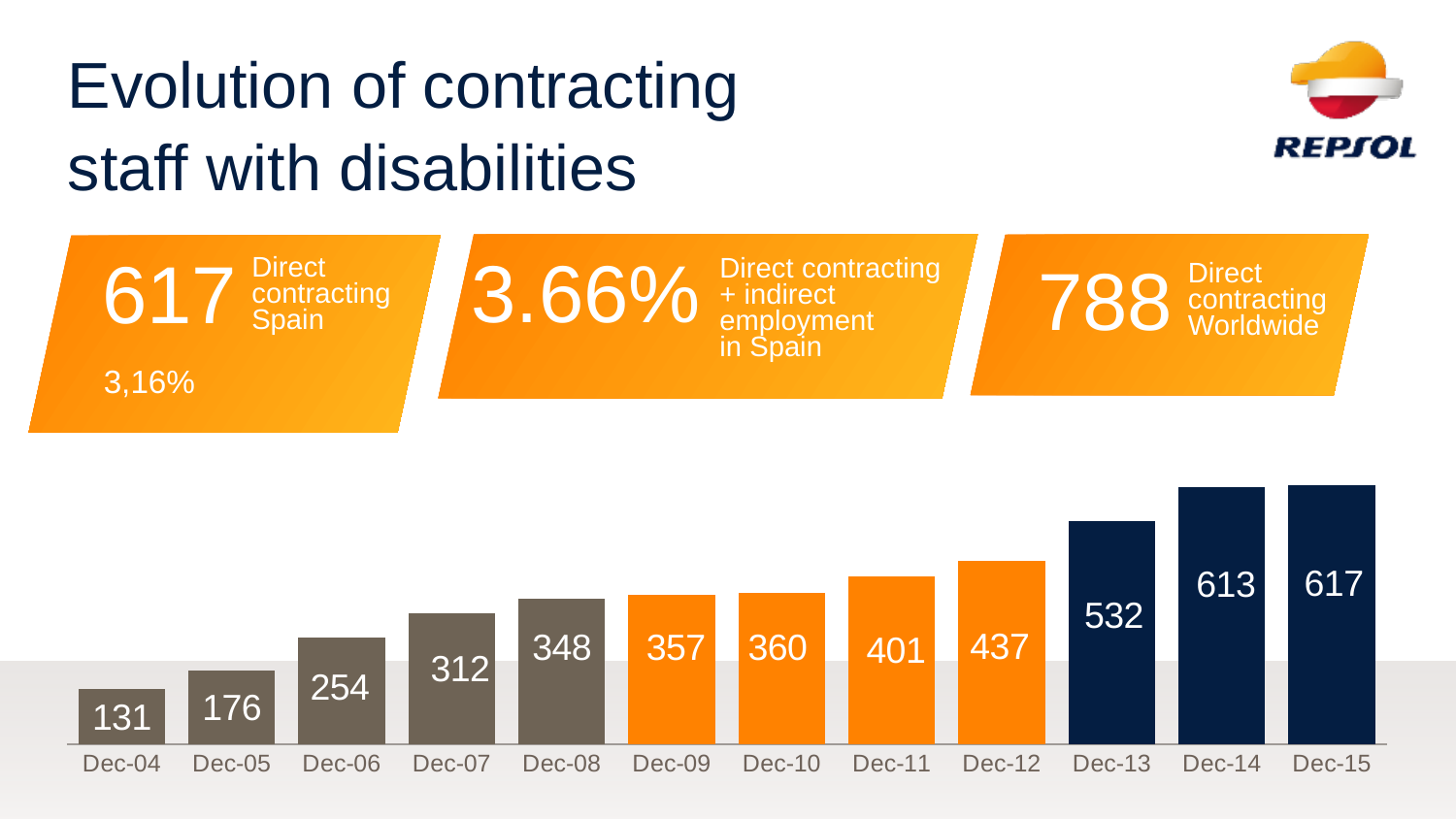
What is the value for Dec-04? 131 What is the value for Dec-13? 532 Do the values rise or fall from Dec-04 to Dec-15? rise What colour are the bars for Dec-13, Dec-14 and Dec-15? dark navy blue Which category has the lowest value? Dec-04 What is the difference between the values for Dec-15 and Dec-04? 486 Which is larger, the value for Dec-07 or the value for Dec-09? Dec-09 What kind of chart is shown on the slide? bar chart What is the value for Dec-10? 360 How many categories are shown on the x axis? 12 What is the difference between the values for Dec-12 and Dec-11? 36 Which category has the highest value? Dec-15